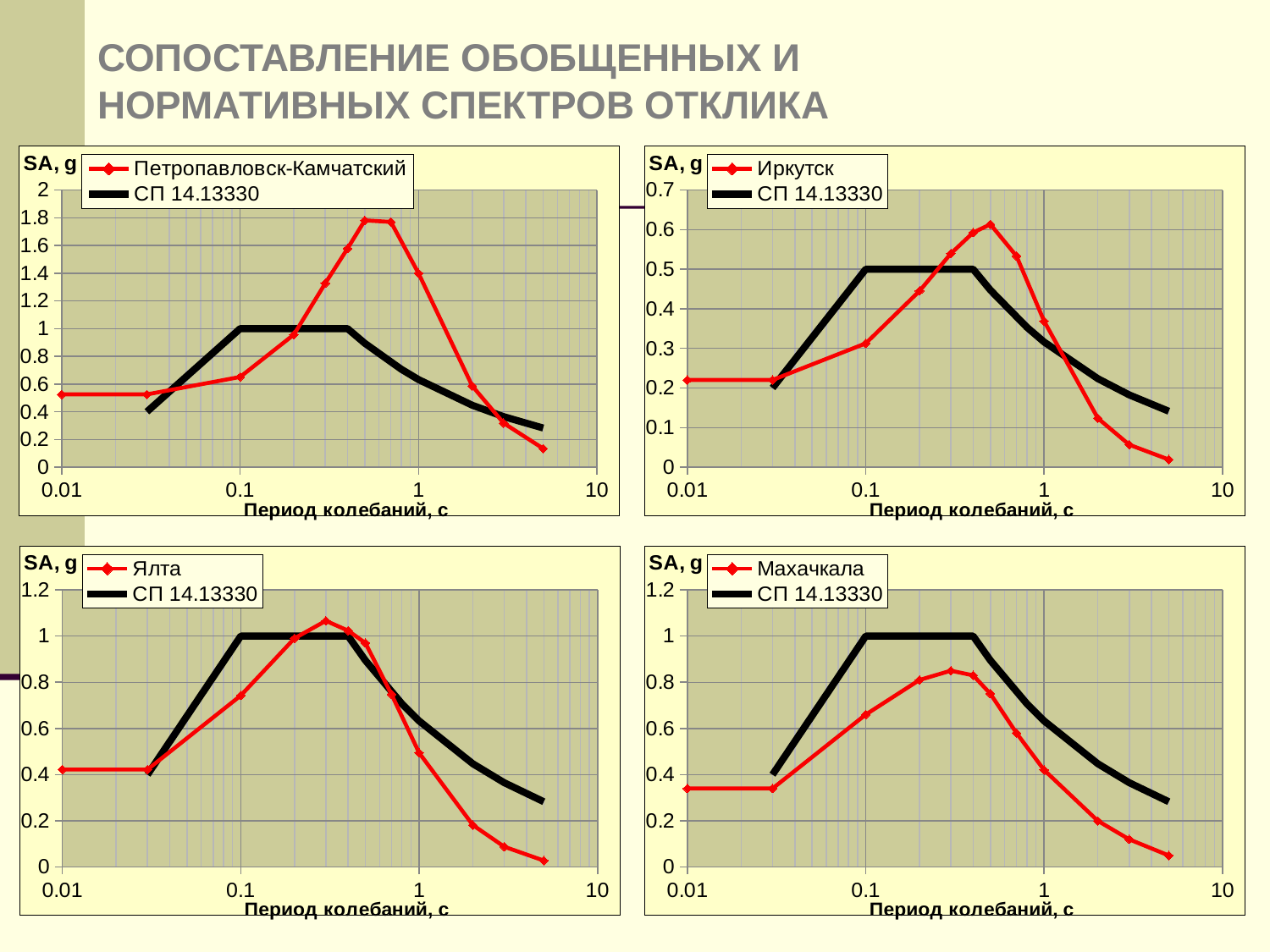
In the Петропавловск-Камчатский chart (top left), at a period of 0.5 s, which series has the higher value: Петропавловск-Камчатский or СП 14.13330? Петропавловск-Камчатский How many charts are on the slide? 4 In the Махачкала chart (bottom right), at a period of 0.1 s, which series has the higher value: Махачкала or СП 14.13330? СП 14.13330 In the Махачкала chart (bottom right), is the peak value of the red Махачкала line greater or less than 1? less What is the x-axis label of the charts? Период колебаний, с In the Ялта chart (bottom left), does the red Ялта line rise or fall between periods 1 and 5? fall What kind of chart is the Петропавловск-Камчатский chart (top left)? line chart In the Махачкала chart (bottom right), what is the value of the flat plateau of the СП 14.13330 line? 1 In the Иркутск chart (top right), what is the value of the flat plateau of the СП 14.13330 line? 0.5 How many series does the legend of the Иркутск chart (top right) list? 2 In the Иркутск chart (top right), is the value of the red Иркутск line at period 5 greater or less than 0.1? less In the Петропавловск-Камчатский chart (top left), is the peak value of the red Петропавловск-Камчатский line greater or less than 1.6? greater